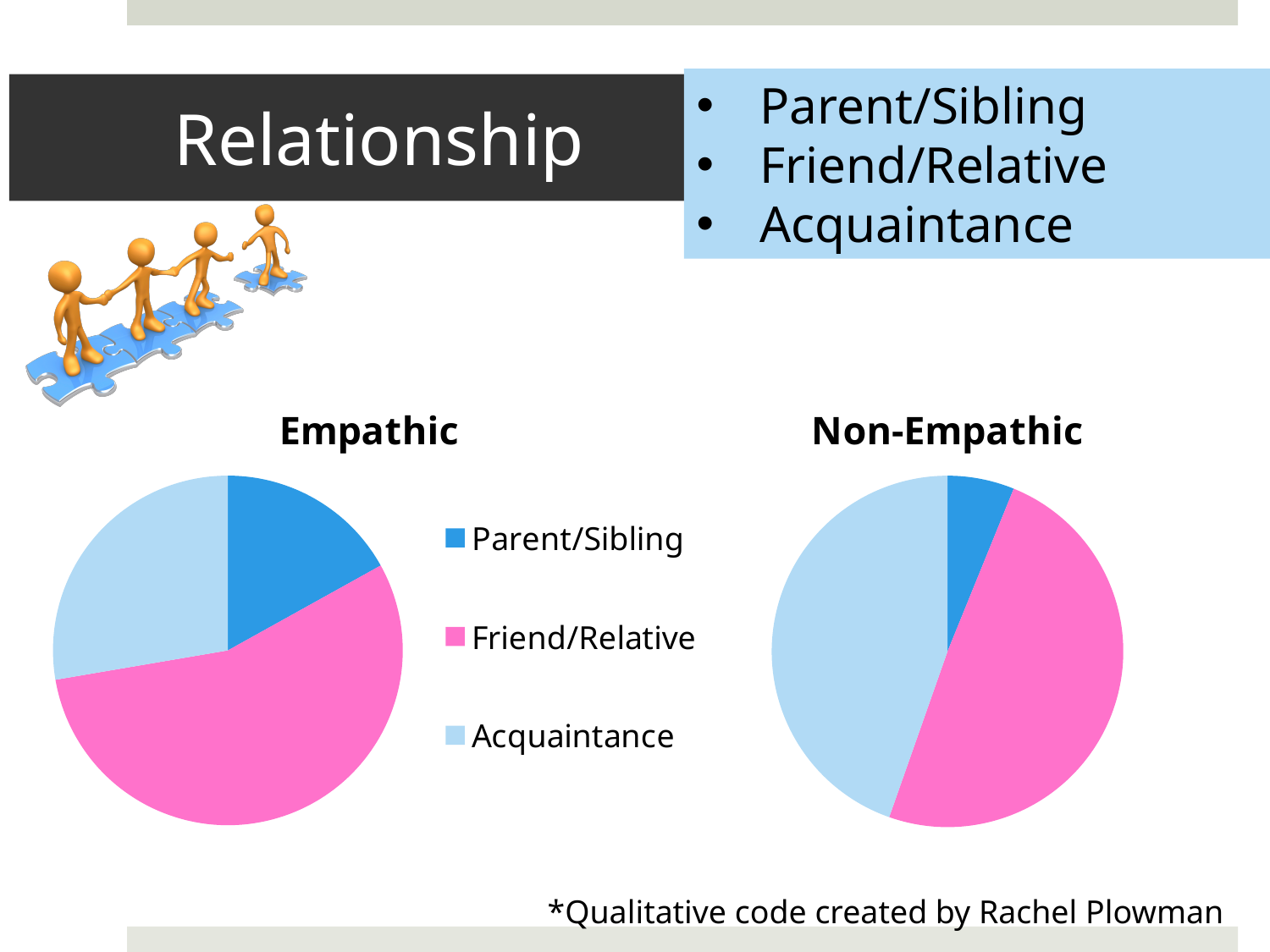
In the Non-Empathic pie chart, which slice is larger: Parent/Sibling or Acquaintance? Acquaintance In the Empathic pie chart, which category has the largest slice? Friend/Relative Which category is shown in pink in the pie charts? Friend/Relative How many charts are shown on the slide? 2 In the Empathic pie chart, which slice is larger: Friend/Relative or Acquaintance? Friend/Relative In the Non-Empathic pie chart, which category has the smallest slice? Parent/Sibling Which pie chart has the smaller Parent/Sibling slice, Empathic or Non-Empathic? Non-Empathic What kind of chart is the Non-Empathic chart? pie chart How many categories does the legend list for the pie charts? 3 What are the titles of the two pie charts on the slide? Empathic and Non-Empathic What kind of chart is the Empathic chart? pie chart In the Empathic pie chart, which category has the smallest slice? Parent/Sibling